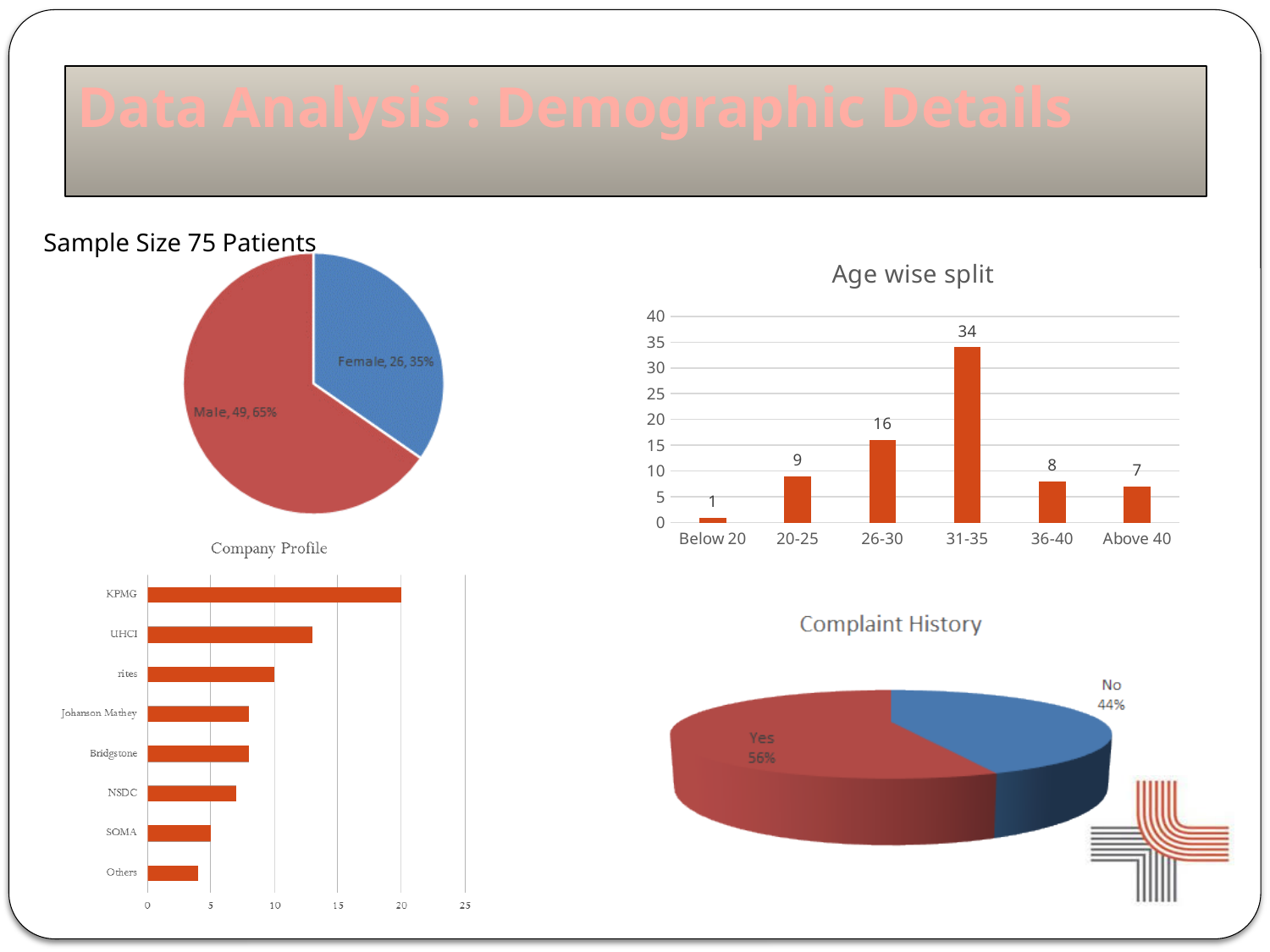
In the Complaint History chart, which slice is larger, Yes or No? Yes In the Age wise split chart, which age group has the highest value? 31-35 In the Company Profile chart, how many companies are listed? 8 In the Age wise split chart, what is the value for the 31-35 age group? 34 What kind of chart is the Company Profile chart? Bar chart In the Company Profile chart, is the value for UHCI greater or less than 10? greater In the gender pie chart at the top left, what share of the pie is Female? 35% In the Age wise split chart, what is the difference between the values for 31-35 and 26-30? 18 In the Company Profile chart, which company has the longest bar? KPMG In the Age wise split chart, how many age groups are shown on the x axis? 6 In the Age wise split chart, which age group has the lowest value? Below 20 In the Age wise split chart, which is larger, the value for 20-25 or the value for 36-40? 20-25